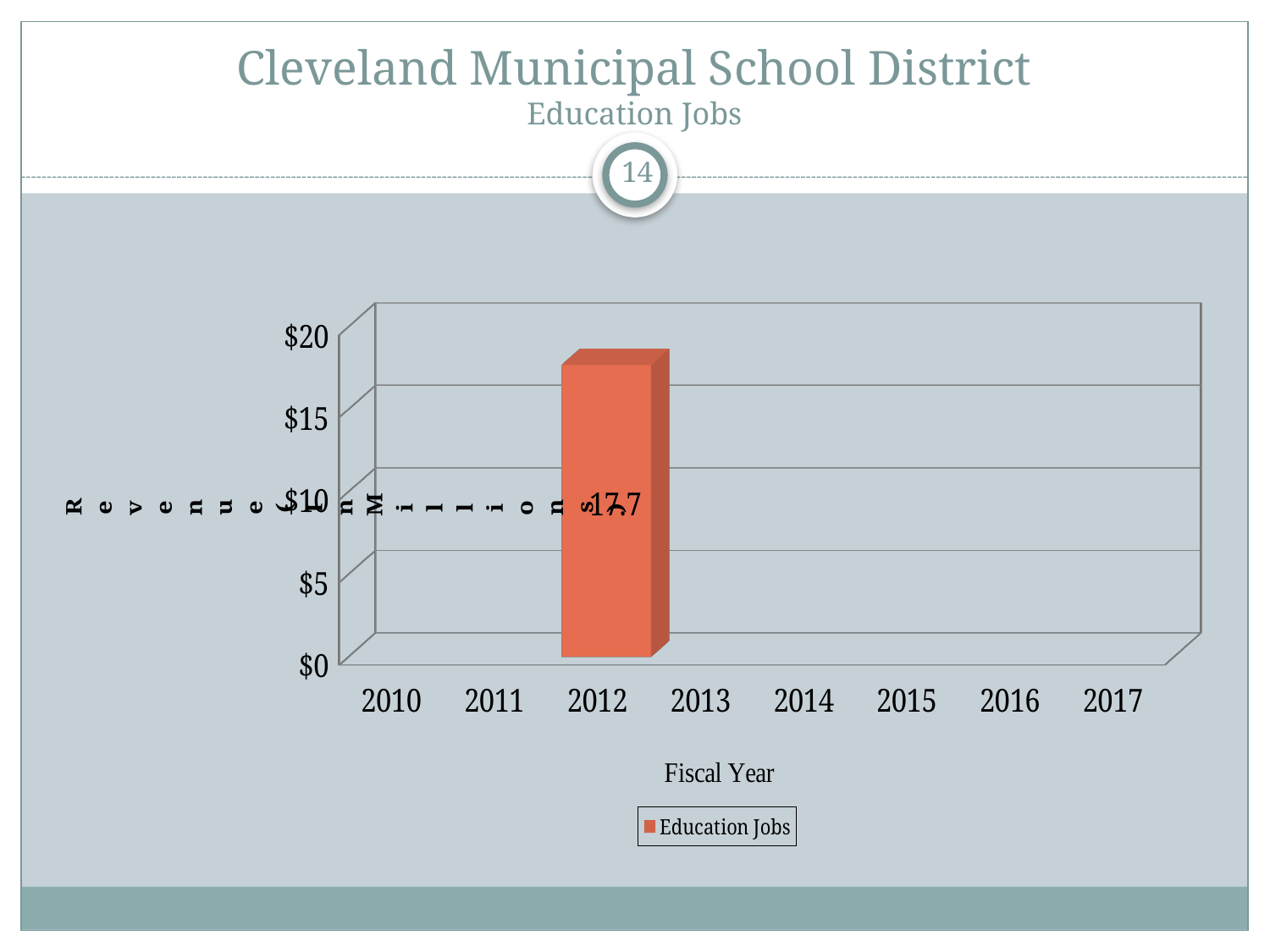
What is the name of the series shown in the legend? Education Jobs What is the first fiscal year shown on the x axis? 2010 How many series does the legend list? 1 Is the value for 2012 greater or less than $20? less What is the value of the Education Jobs bar for fiscal year 2012? 17.7 Is the value for 2012 greater or less than $15? greater What kind of chart is shown on the slide? bar chart Which fiscal year has the highest Education Jobs value? 2012 What is the last fiscal year shown on the x axis? 2017 What is the highest value shown on the y axis? $20 How many fiscal years are shown on the x axis? 8 What is the label of the x axis? Fiscal Year